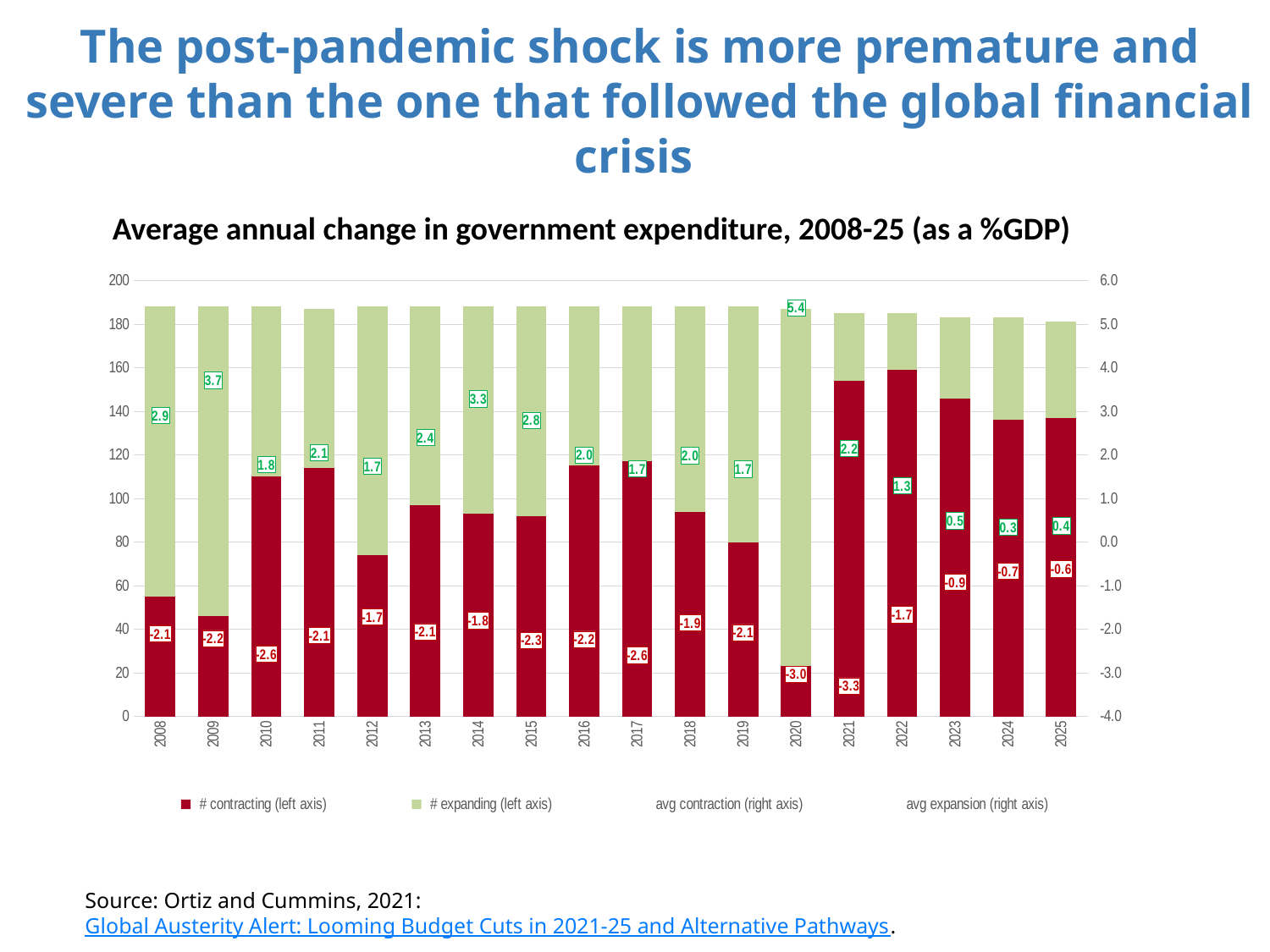
How many years are shown on the x axis? 18 Is the # contracting (left axis) value for 2022 greater or less than 140? greater Do the avg expansion values rise or fall from 2021 to 2024? fall Which year has the highest avg expansion value? 2020 What is the avg contraction (right axis) value for 2021? -3.3 How many series does the legend list? 4 Which year has the lowest avg expansion value? 2024 Is the # contracting (left axis) value for 2020 greater or less than 40? less What is the avg expansion value for 2009? 3.7 What is the difference between the avg expansion values for 2009 and 2008? 0.8 What is the avg expansion (right axis) value for 2020? 5.4 Which is larger in magnitude, the avg contraction for 2010 or for 2012? 2010